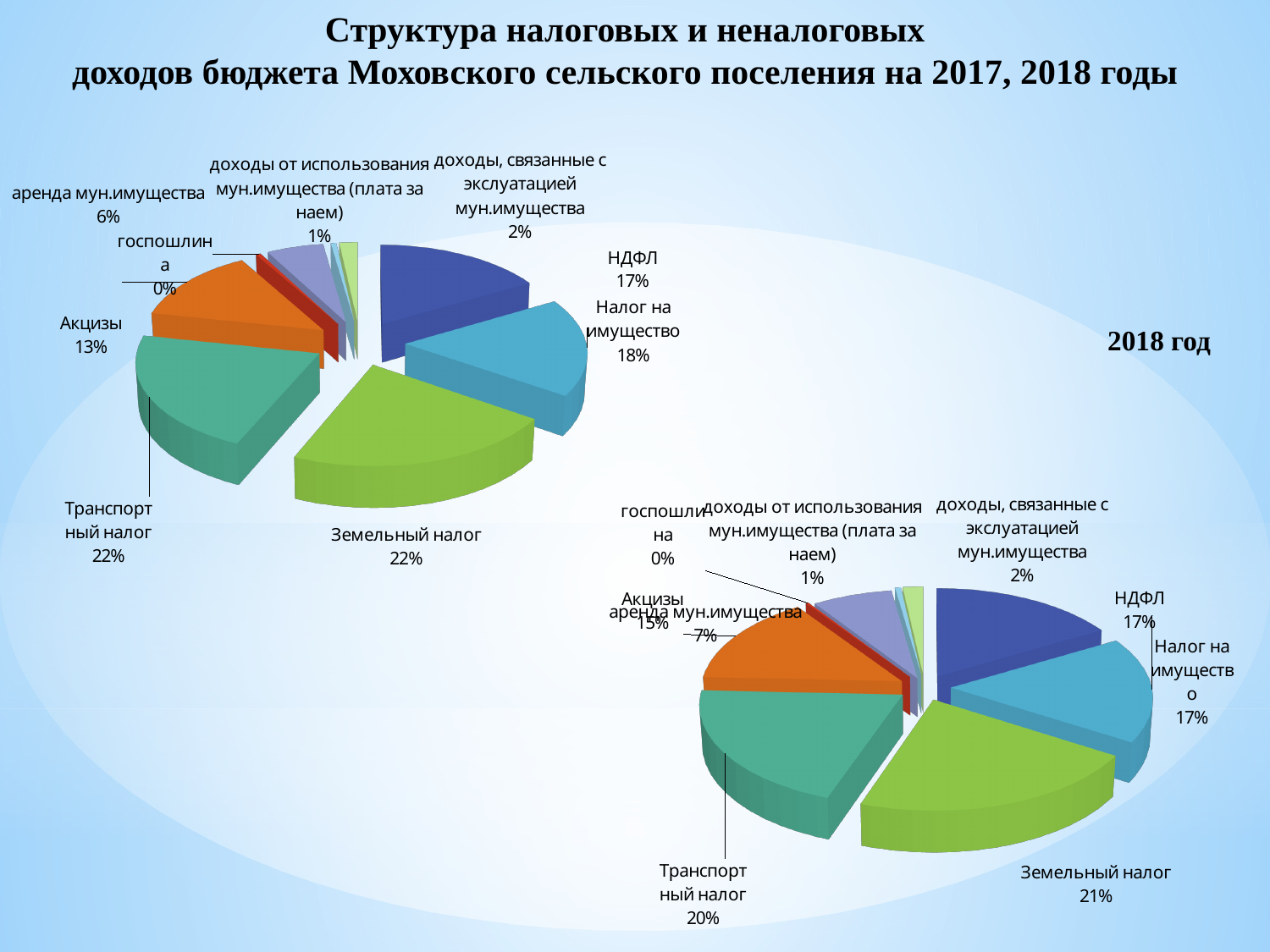
In the upper-left pie chart, what share does Налог на имущество have? 18% How many categories are shown in the lower-right pie chart? 9 In the lower-right pie chart, which is larger: the share of Акцизы or the share of аренда мун.имущества? Акцизы In the upper-left pie chart, what is the difference between the shares of Налог на имущество and НДФЛ? 1% In the lower-right pie chart, which category has the smallest share? госпошлина In the lower-right pie chart, which category has the largest share? Земельный налог In the lower-right pie chart, what share does аренда мун.имущества have? 7% In the lower-right pie chart, what share does Транспортный налог have? 20% Which year is labelled next to the charts on the slide? 2018 год What kind of chart is the upper-left chart on the slide? pie chart In the upper-left pie chart, what share does Земельный налог have? 22% In the upper-left pie chart, what share does Акцизы have? 13%